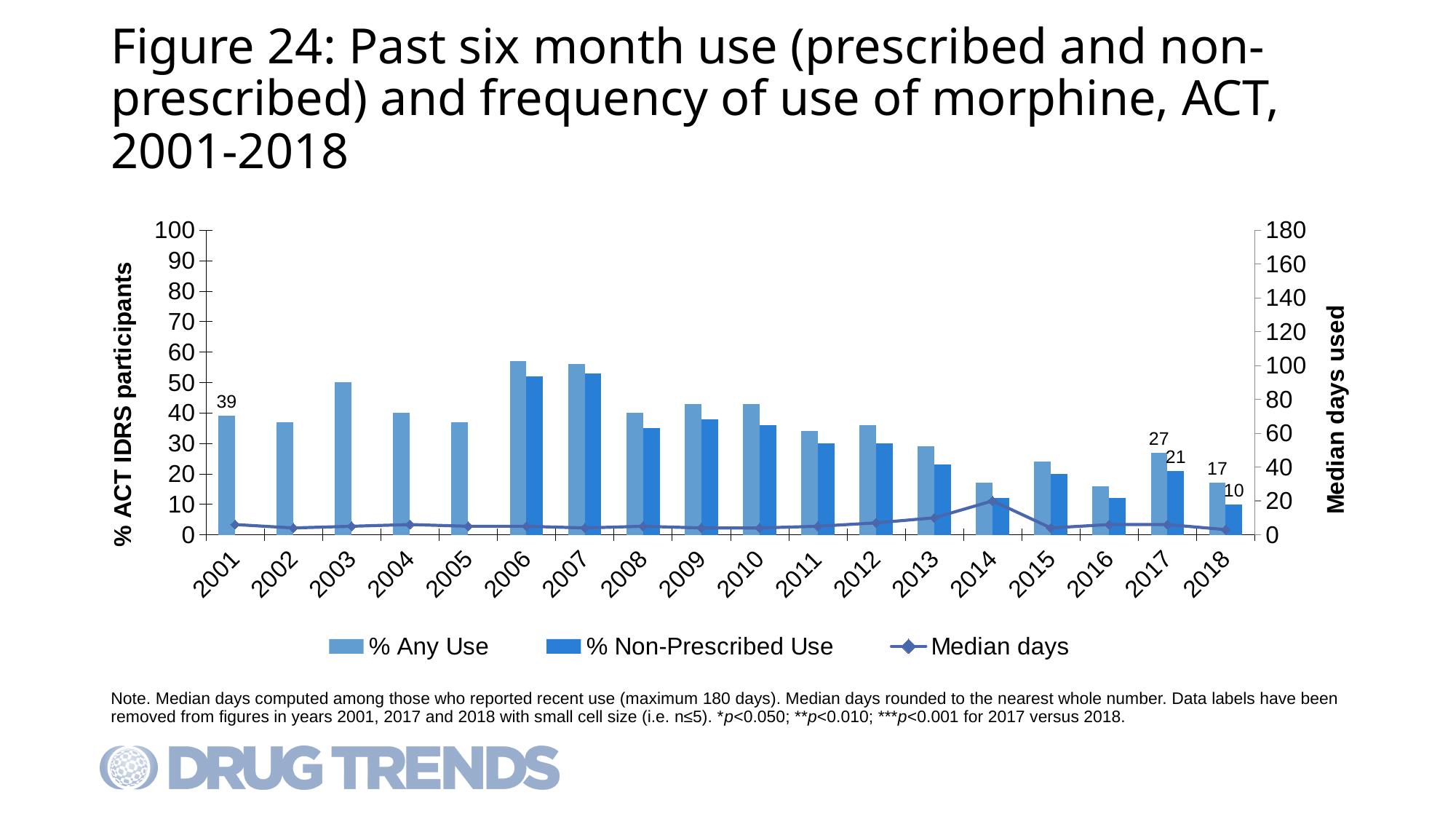
What is the % Non-Prescribed Use value for 2018? 10 Is the % Any Use value for 2006 greater or less than 50? greater How many series does the legend list? 3 By how much did % Any Use fall from 2001 to 2018? 22 Is the % Any Use value for 2014 greater or less than 20? less What is the % Any Use value for 2018? 17 What is the % Any Use value for 2001? 39 What is the difference between % Any Use and % Non-Prescribed Use in 2017? 6 What is the % Non-Prescribed Use value for 2017? 21 Which year has the highest Median days value? 2014 Which is larger, % Any Use in 2017 or % Any Use in 2018? 2017 How many years are shown on the x axis? 18